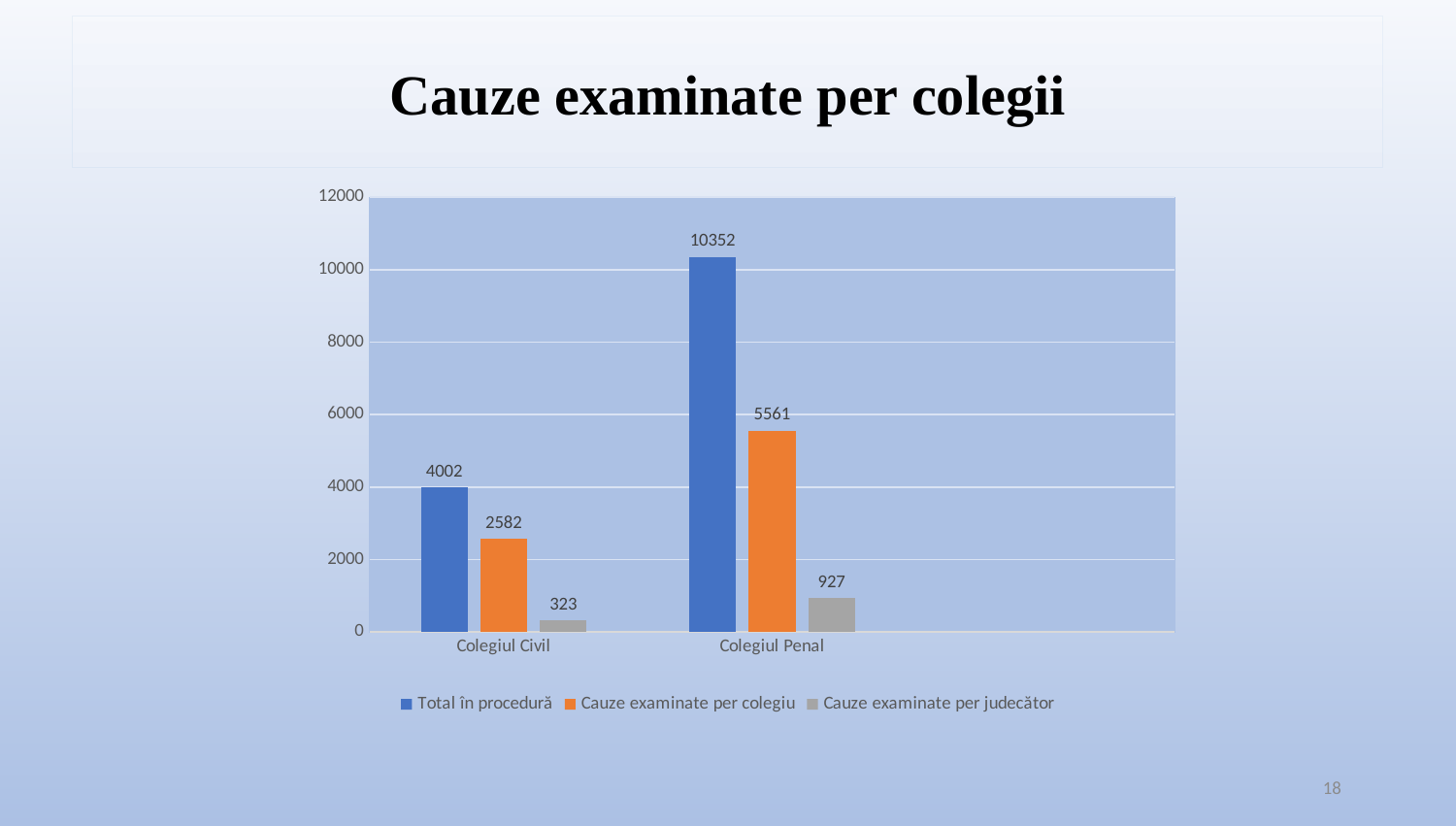
What is the value of "Cauze examinate per colegiu" for Colegiul Penal? 5561 What is the value of "Total în procedură" for Colegiul Civil? 4002 How many categories are shown on the x axis? 2 Which category has the lowest value for "Cauze examinate per judecător"? Colegiul Civil Is the value of "Total în procedură" for Colegiul Penal greater or less than 10000? greater Which category has the highest value for "Total în procedură"? Colegiul Penal What is the difference between "Cauze examinate per colegiu" for Colegiul Penal and Colegiul Civil? 2979 What is the value of "Total în procedură" for Colegiul Penal? 10352 How many series does the legend list? 3 Which is larger: "Cauze examinate per judecător" for Colegiul Penal or for Colegiul Civil? Colegiul Penal What type of chart is shown on the slide? Bar chart What is the value of "Cauze examinate per judecător" for Colegiul Civil? 323